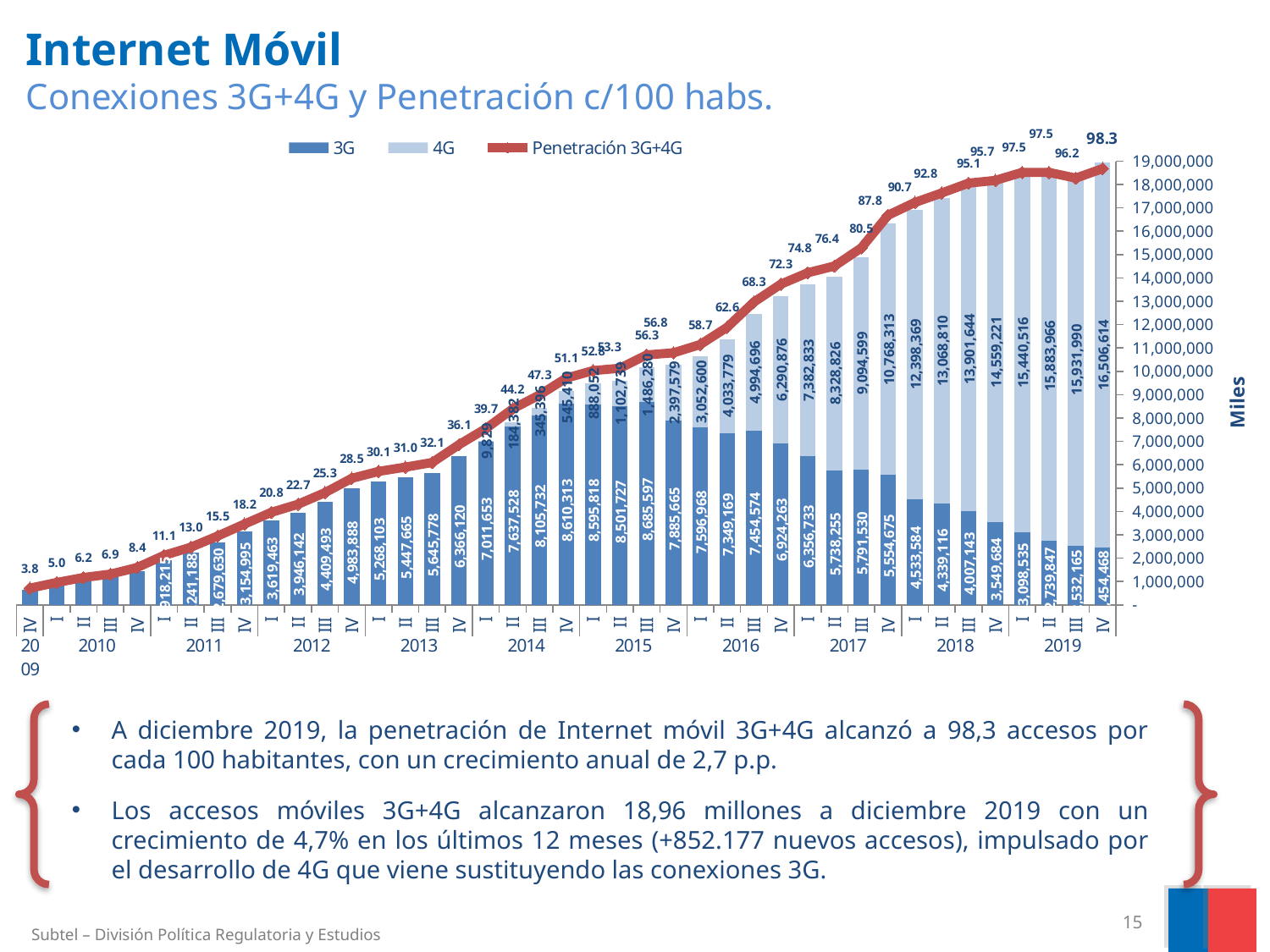
What is the 3G value for I 2012? 3,619,463 What is the 4G value for IV 2019? 16,506,614 In which quarter does the 3G series reach its highest value? III 2015 Does the Penetración 3G+4G line generally rise or fall from IV 2009 to IV 2019? Rise In IV 2019, which is larger, the 3G value or the 4G value? 4G What is the lowest Penetración 3G+4G value shown, and in which quarter? 3.8, IV 2009 How many series does the chart legend list? 3 What is the total of the stacked bar (3G + 4G) for IV 2019? 18,961,082 What is the 3G value for IV 2019? 2,454,468 What kind of chart is shown on the slide? Combined stacked bar and line chart What is the difference between the 4G values for IV 2019 and III 2019? 574,624 What is the Penetración 3G+4G value for IV 2019? 98.3